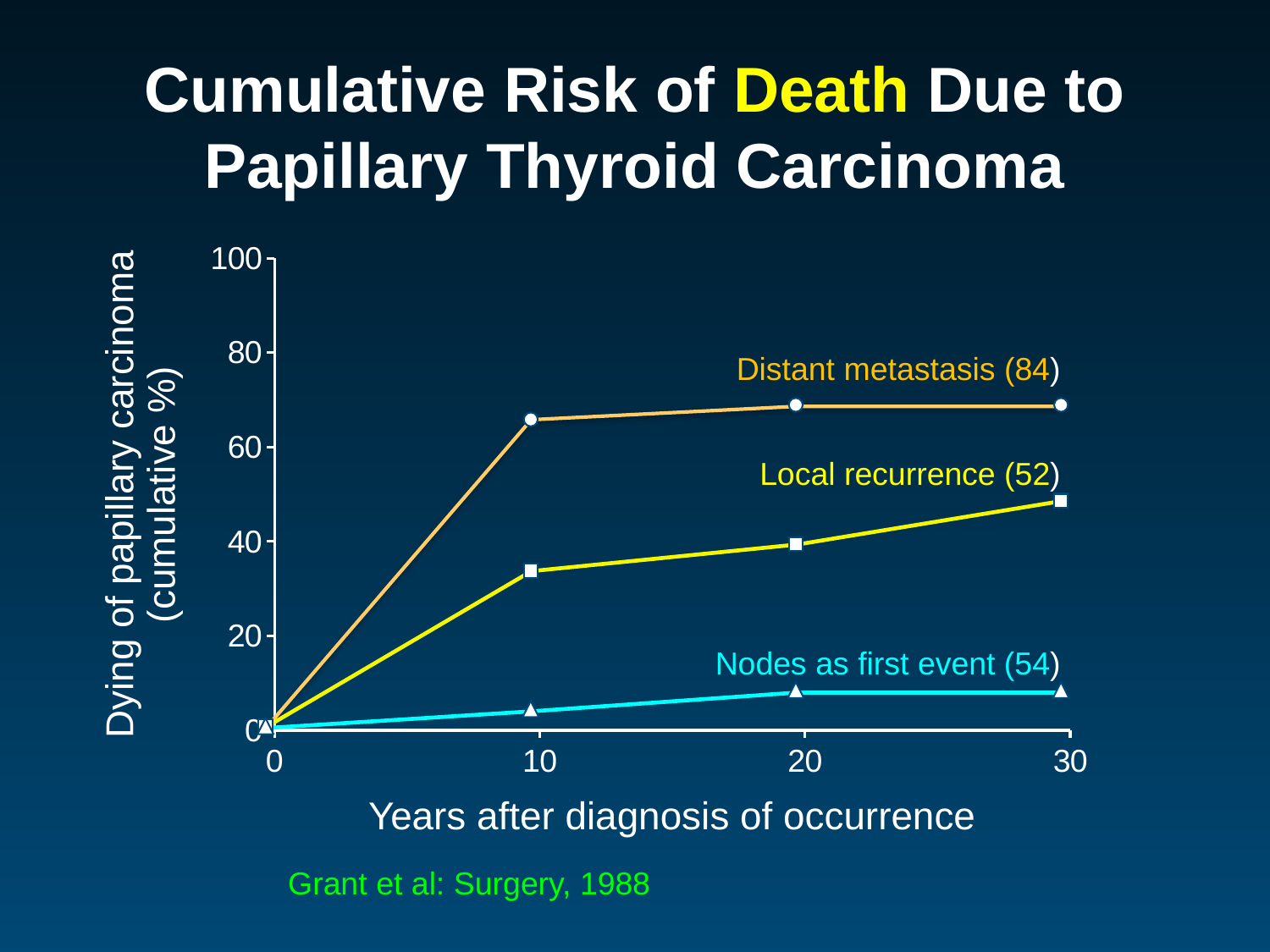
How many series are plotted on the chart? 3 At 20 years, which is larger: the value for Local recurrence or the value for Nodes as first event? Local recurrence Is the value for Distant metastasis at 10 years greater or less than 60? greater Is the value for Local recurrence at 30 years greater or less than 60? less Is the value for Nodes as first event at 20 years greater or less than 20? less Which series has the highest cumulative risk of death at 30 years? Distant metastasis Which series has the lowest cumulative risk of death at 30 years? Nodes as first event What kind of chart is shown on the slide? Line chart What number is shown in parentheses next to the Distant metastasis label? 84 Does the Local recurrence line rise or fall as years after diagnosis increase? Rises What is the label of the x axis? Years after diagnosis of occurrence